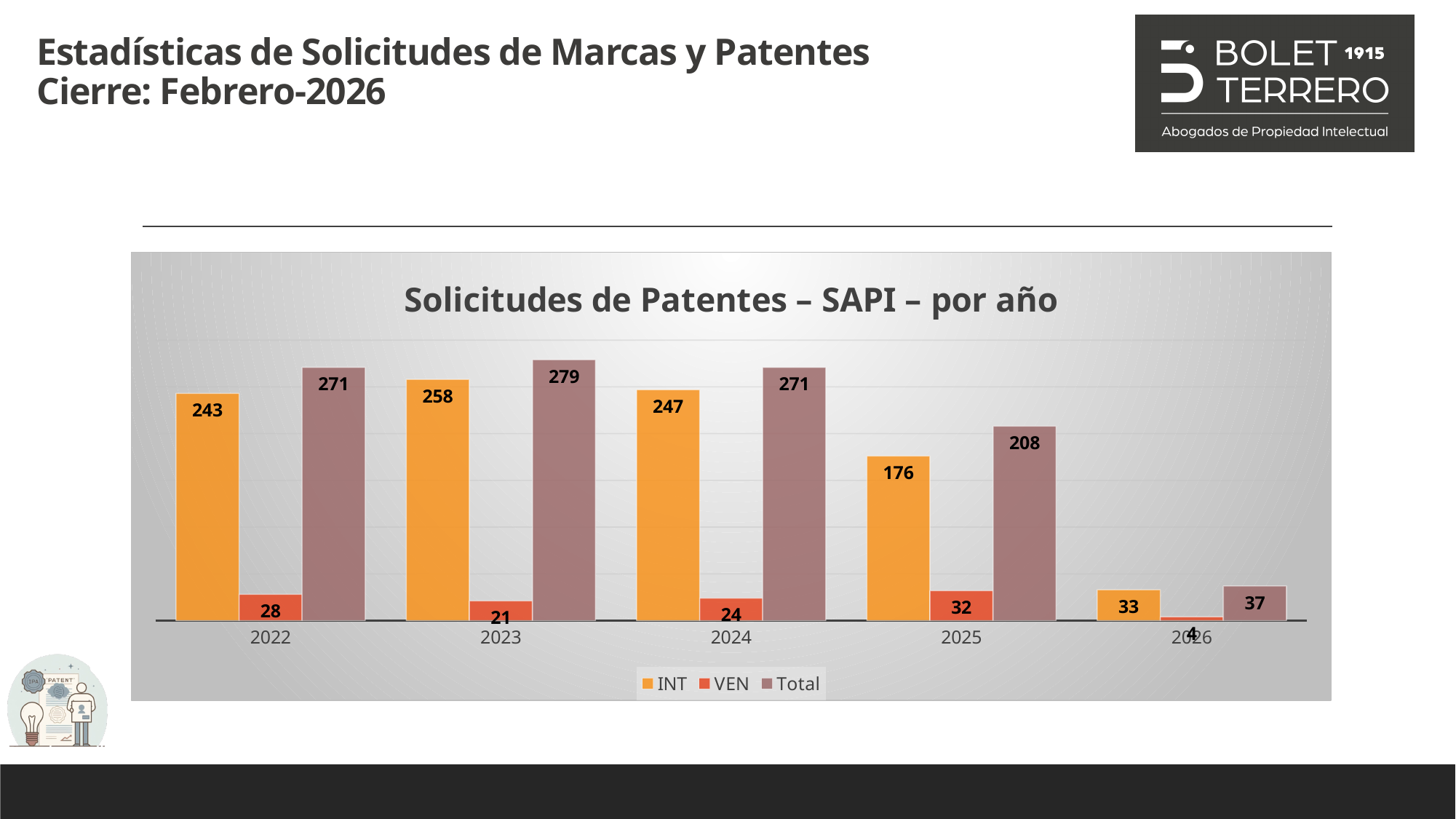
How many years are shown on the x axis? 5 Which year has the highest Total value? 2023 Which year has the lowest INT value? 2026 What is the Total value for 2024? 271 What is the INT value for 2023? 258 What is the VEN value for 2025? 32 Do the Total values rise or fall from 2023 to 2026? Fall Which is larger, the VEN value for 2022 or the VEN value for 2024? 2022 What is the difference between the Total values for 2023 and 2025? 71 How many series does the legend list? 3 What kind of chart is shown? Bar chart What is the title of the chart? Solicitudes de Patentes – SAPI – por año